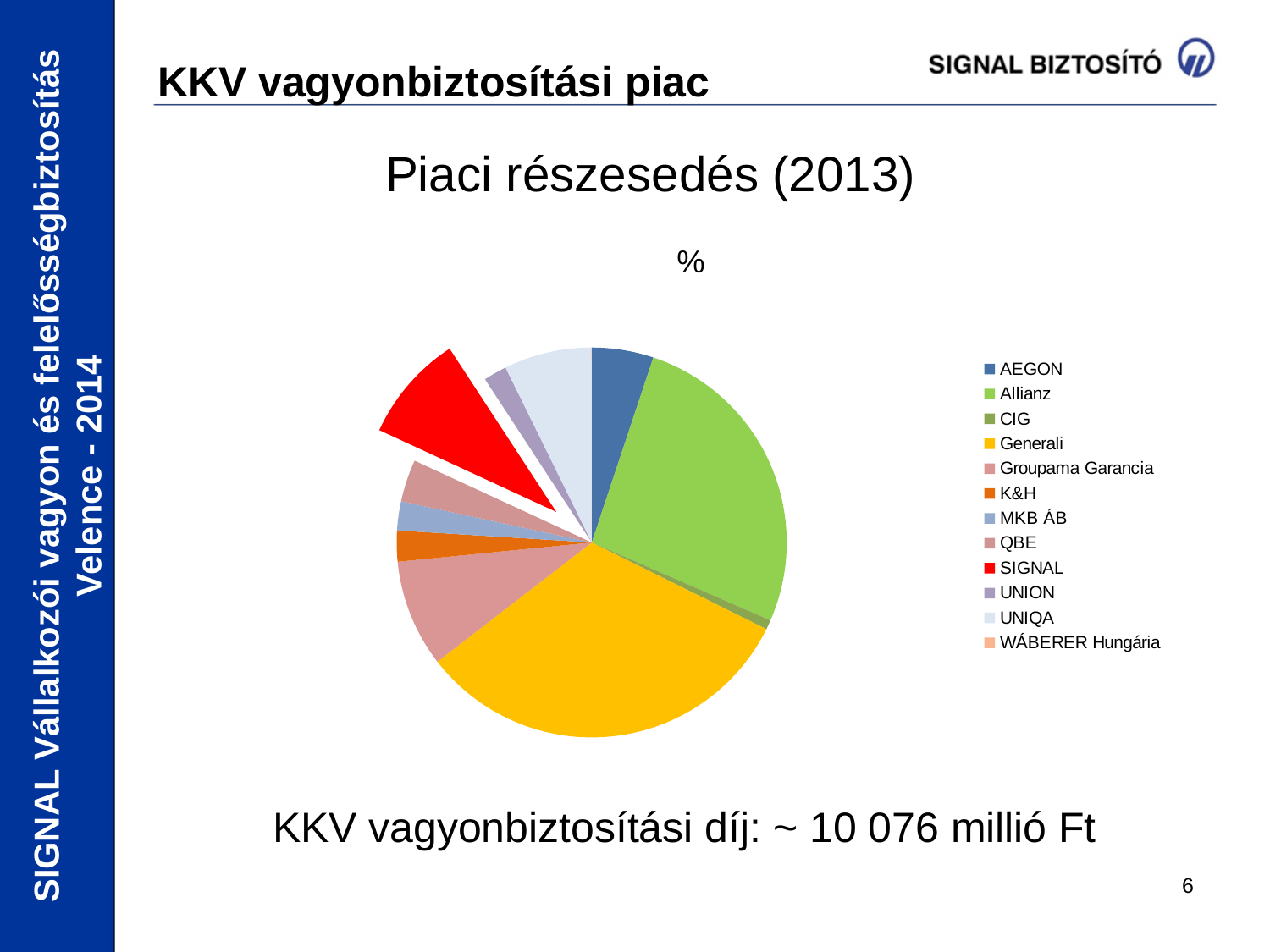
Which slice is larger, Allianz or SIGNAL? Allianz Which company has the largest slice of the pie chart? Generali Which company's slice is pulled out (exploded) from the pie chart? SIGNAL What is the title shown above the pie chart? % Which year does the market share chart refer to? 2013 Which slice is larger, Generali or AEGON? Generali What kind of chart is shown on the slide? pie chart Which slice is larger, SIGNAL or UNION? SIGNAL How many categories does the legend of the pie chart list? 12